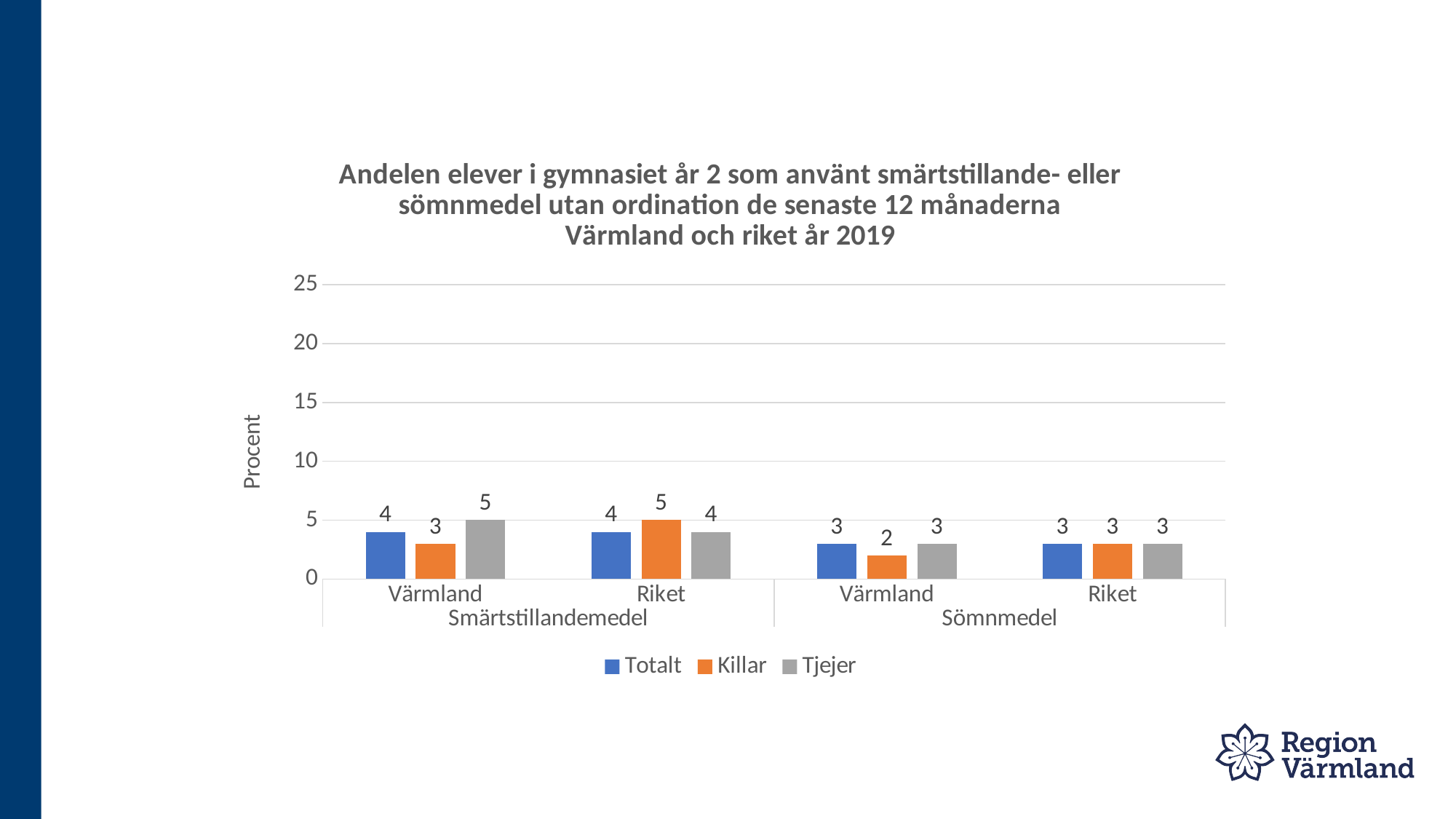
Which series has the lowest value in Värmland under Sömnmedel? Killar What is the label of the vertical axis? Procent What kind of chart is shown on the slide? bar chart Is the value for Totalt in Värmland under Smärtstillandemedel greater or less than 10? less What is the difference between the Tjejer and Killar values in Värmland under Smärtstillandemedel? 2 What is the value for Killar in Riket under Smärtstillandemedel? 5 What is the value for Killar in Värmland under Sömnmedel? 2 Which is larger: the Killar value in Riket under Smärtstillandemedel or the Killar value in Riket under Sömnmedel? Riket under Smärtstillandemedel How many series does the legend list? 3 Which series has the highest value in Värmland under Smärtstillandemedel? Tjejer What is the value for Totalt in Riket under Sömnmedel? 3 What is the value for Tjejer in Värmland under Smärtstillandemedel? 5